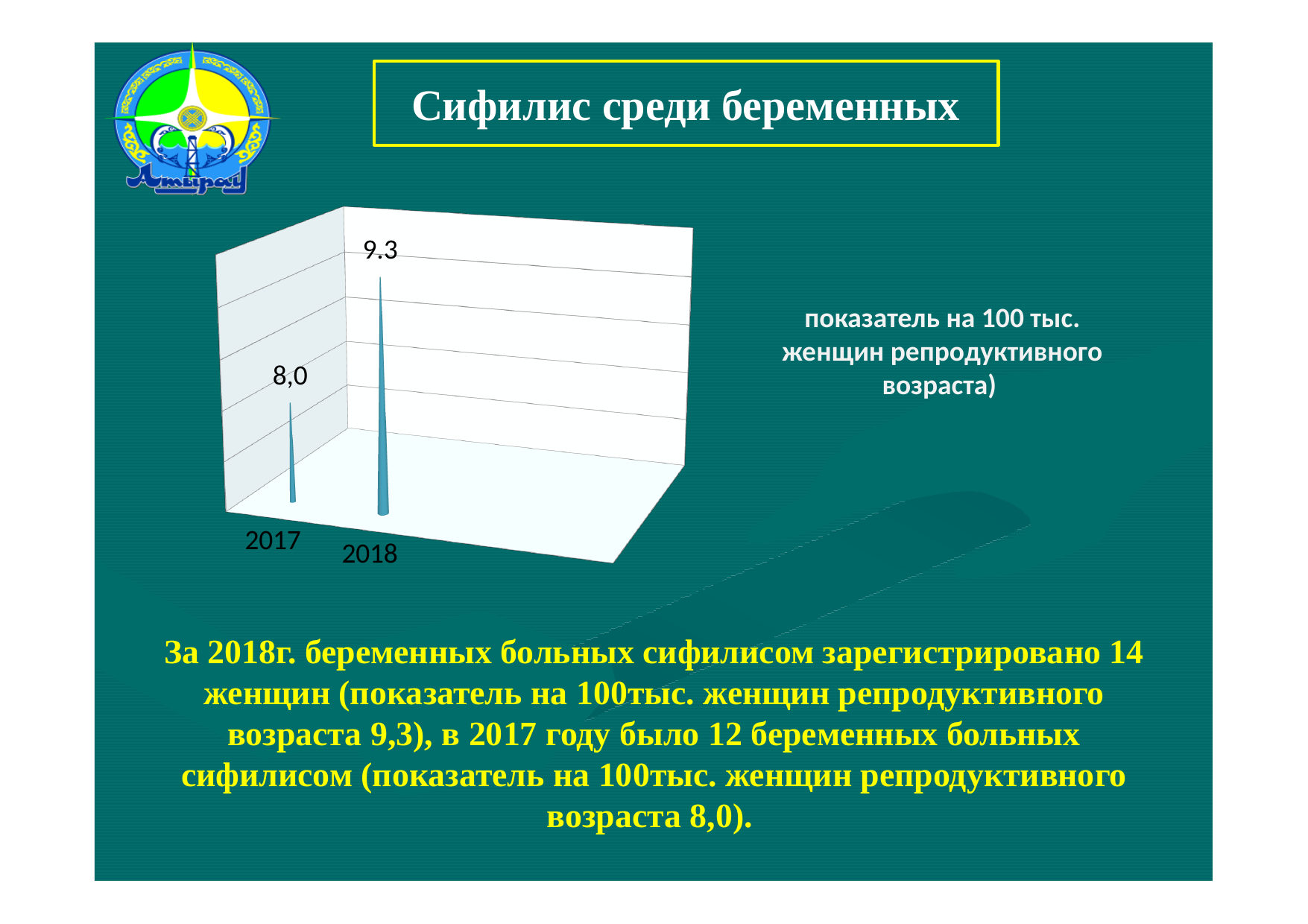
How many years are plotted on the chart? 2 By how much does the value for 2018 exceed the value for 2017? 1.3 Which year has the lower value? 2017 What is the value shown for 2018? 9.3 Do the values rise or fall from 2017 to 2018? rise What is the value shown for 2017? 8,0 What colour are the bars on the chart? blue Is the value for 2018 larger or smaller than the value for 2017? larger Which year has the higher value? 2018 What kind of chart is shown on the slide? bar chart What is the title of the chart on the slide? Сифилис среди беременных